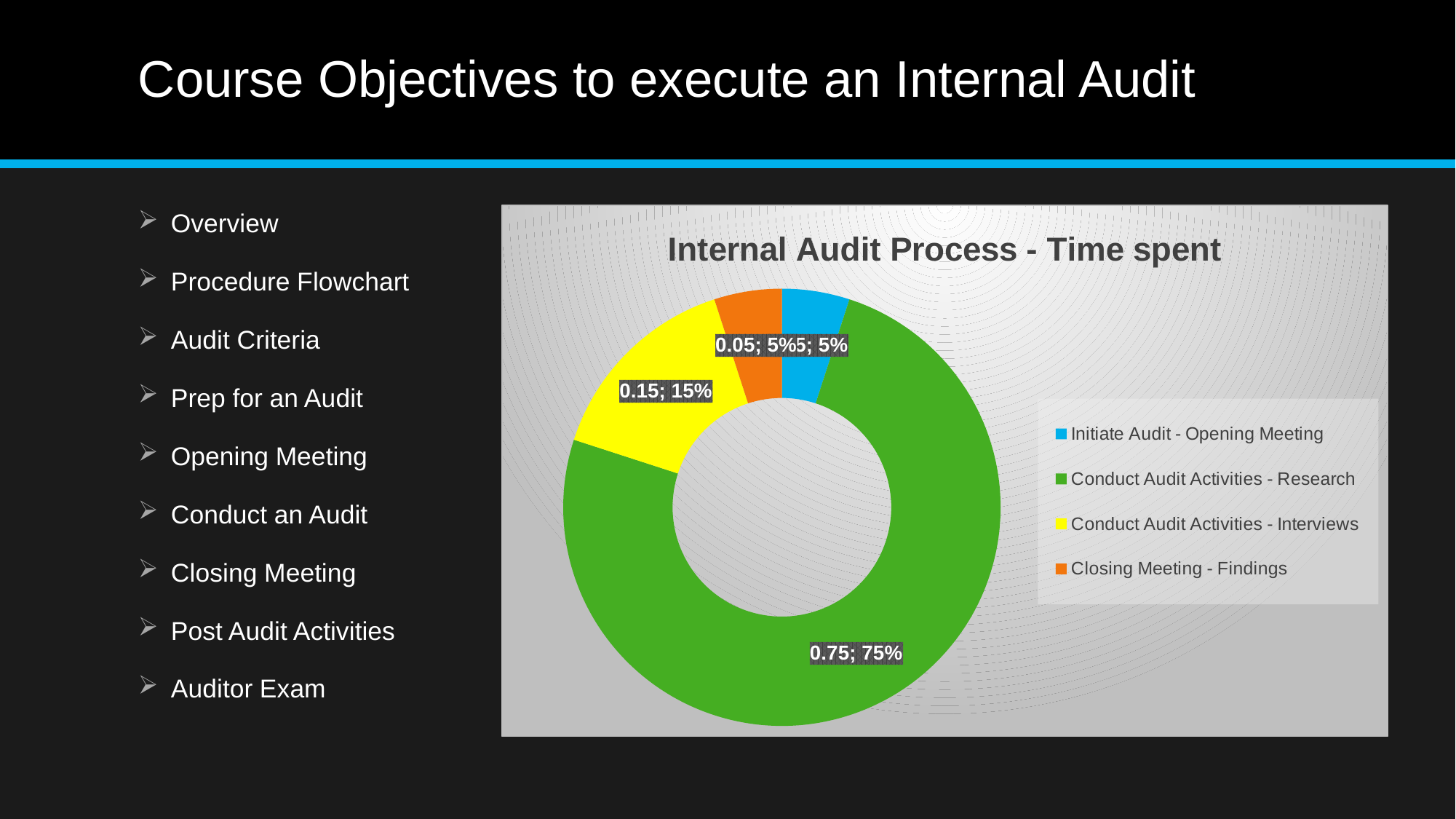
How many entries does the legend list? 4 How many categories does the chart show? 4 Which is larger: the share for Conduct Audit Activities - Research or for Conduct Audit Activities - Interviews? Conduct Audit Activities - Research What share of the chart does Conduct Audit Activities - Interviews represent? 15% What percentage of time is spent on Conduct Audit Activities - Research? 75% What is the difference in percentage points between Conduct Audit Activities - Research and Conduct Audit Activities - Interviews? 60% Which category takes the largest share of time in the chart? Conduct Audit Activities - Research What percentage of time is spent on Conduct Audit Activities - Interviews? 15% What is the title of the chart? Internal Audit Process - Time spent What percentage of time is spent on Closing Meeting - Findings? 5% What colour represents Conduct Audit Activities - Research in the chart? green What kind of chart is shown on the slide? doughnut chart